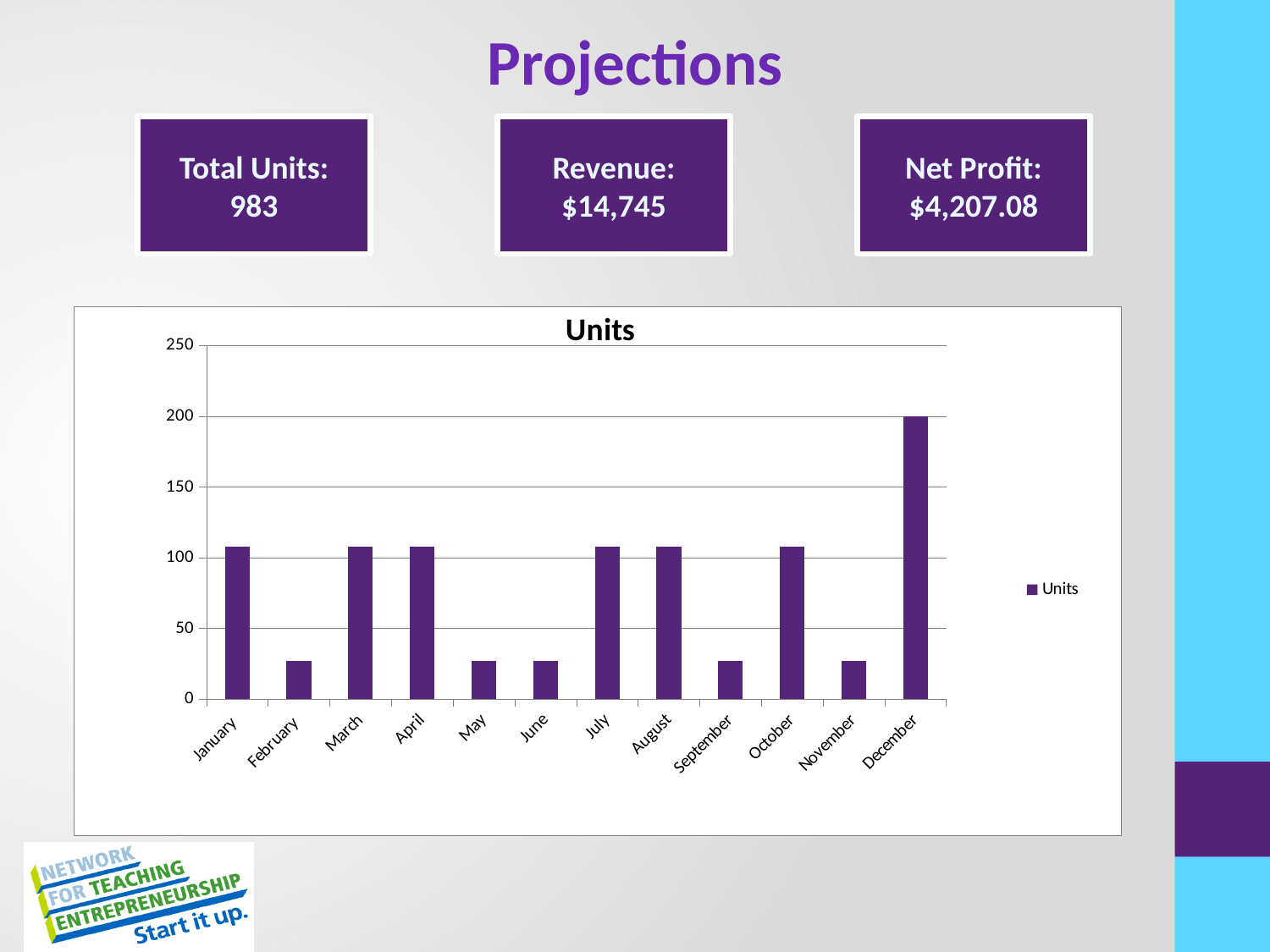
Which month has the highest number of units? December What kind of chart is shown on the slide? bar chart What is the value for December in the Units chart? 200 What is the title of the chart? Units Is the value for January greater or less than 100? greater Is the value for February greater or less than 50? less Is the value for December greater or less than 150? greater Which is larger, the value for September or the value for October? October Which is larger, the value for March or the value for May? March How many months are shown on the x axis of the chart? 12 What is the name of the series listed in the chart's legend? Units How many series does the chart's legend list? 1